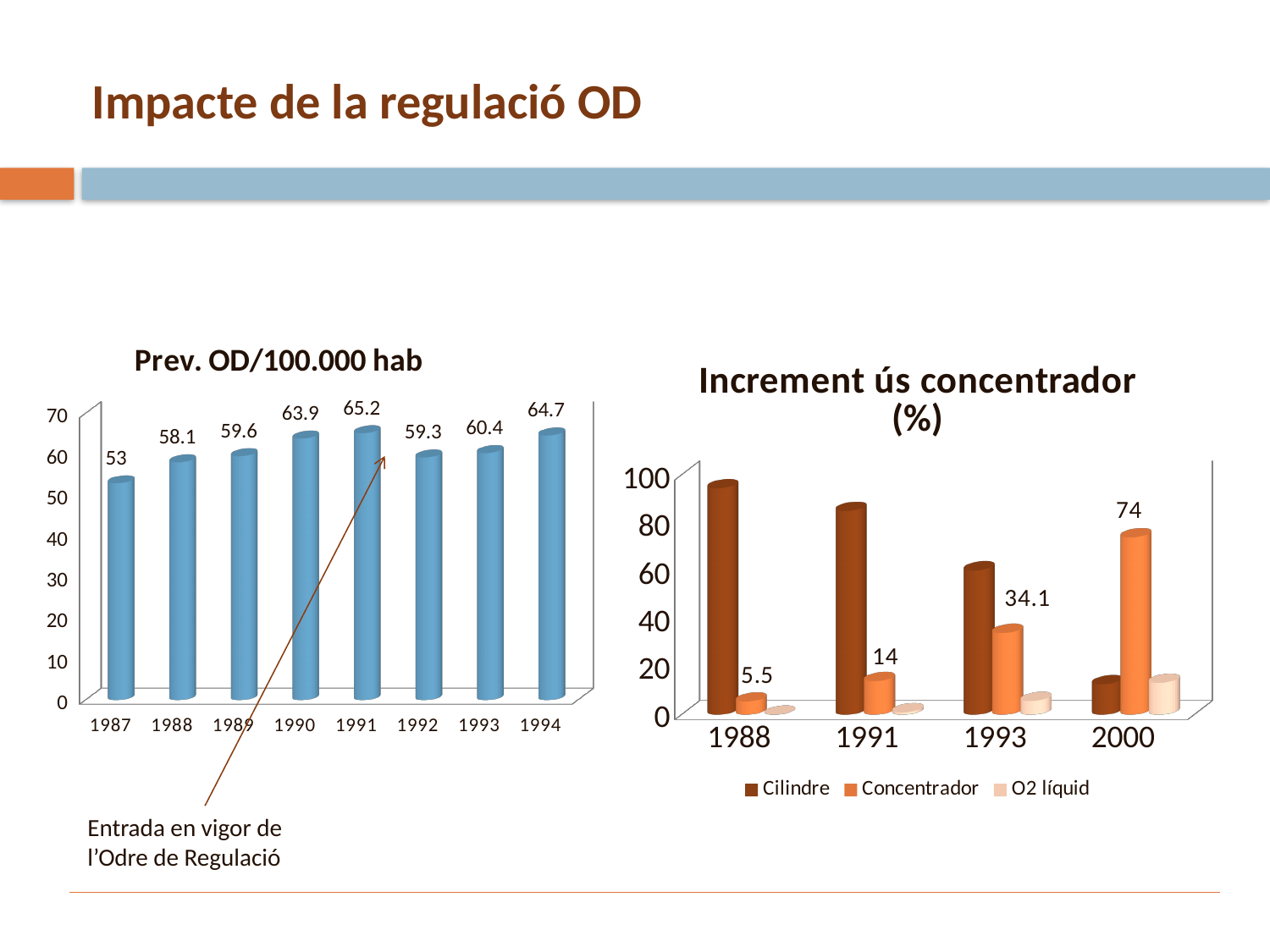
In the 'Increment ús concentrador (%)' chart, what is the Concentrador value for 2000? 74 In the 'Increment ús concentrador (%)' chart, is the Cilindre value for 1988 greater or less than 80? greater In the 'Increment ús concentrador (%)' chart, how many series does the legend list? 3 What kind of chart is the 'Increment ús concentrador (%)' chart? bar chart In the 'Prev. OD/100.000 hab' chart, which year has the lowest value? 1987 In the 'Prev. OD/100.000 hab' chart, is the value for 1990 larger or smaller than the value for 1993? larger In the 'Prev. OD/100.000 hab' chart, what is the difference between the values for 1991 and 1992? 5.9 In the 'Prev. OD/100.000 hab' chart, which year has the highest value? 1991 In the 'Prev. OD/100.000 hab' chart, how many years are shown on the x axis? 8 In the 'Prev. OD/100.000 hab' chart, what is the value for 1991? 65.2 In the 'Increment ús concentrador (%)' chart, do the Concentrador values rise or fall from 1988 to 2000? rise In the 'Increment ús concentrador (%)' chart, what is the Concentrador value for 1993? 34.1